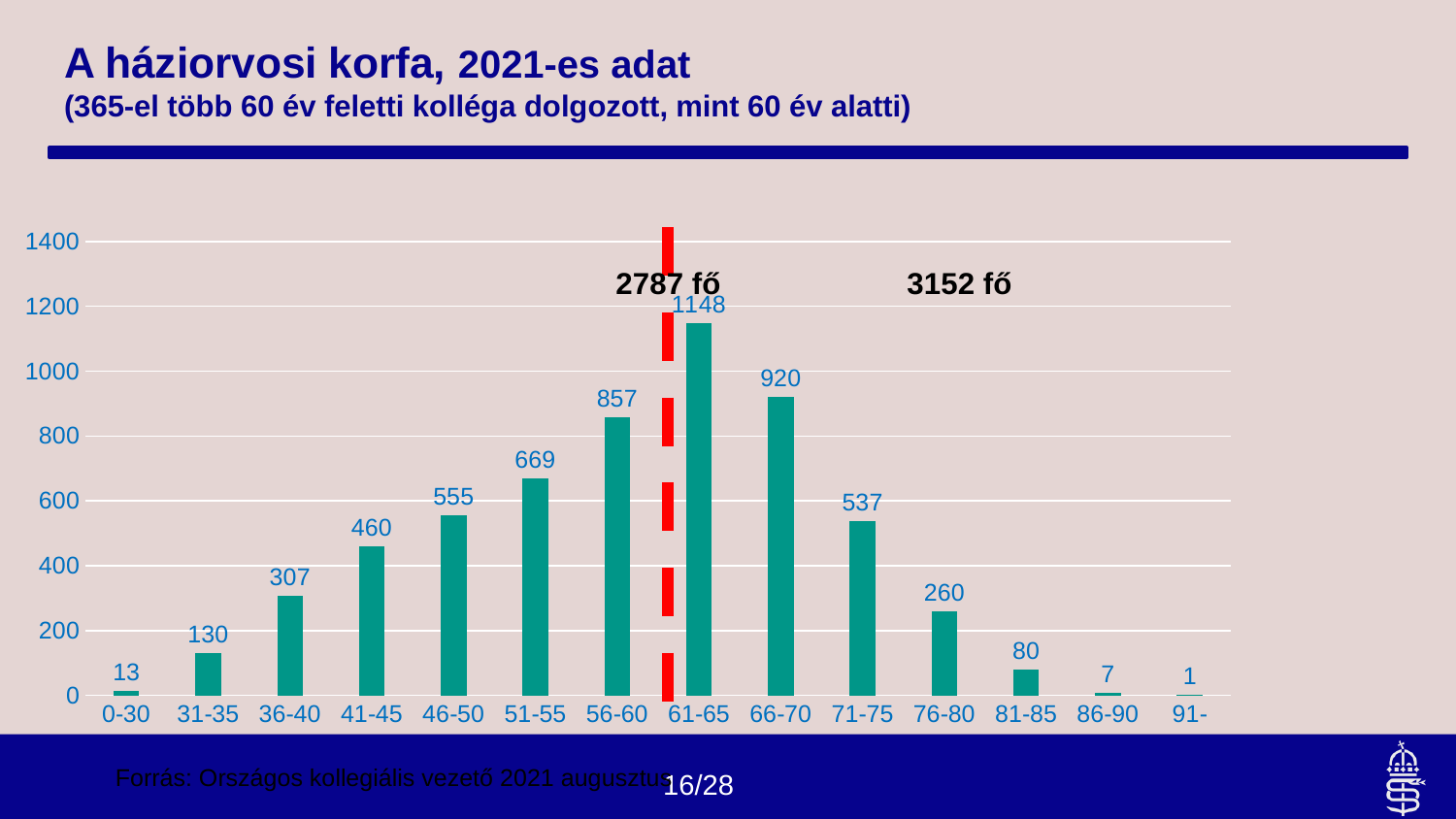
How many age groups are shown on the x axis? 14 What is the title of the chart on the slide? A háziorvosi korfa, 2021-es adat Which is larger, the value for 46-50 or the value for 71-75? 46-50 What is the value for the 76-80 age group? 260 Which age group has the lowest value? 91- What is the difference between the values for 61-65 and 66-70? 228 Which age group has the highest value? 61-65 What kind of chart is shown on the slide? bar chart Is the value for 66-70 greater or less than 1000? less What is the difference between the values for 56-60 and 51-55? 188 What is the value for the 36-40 age group? 307 What is the value for the 61-65 age group? 1148